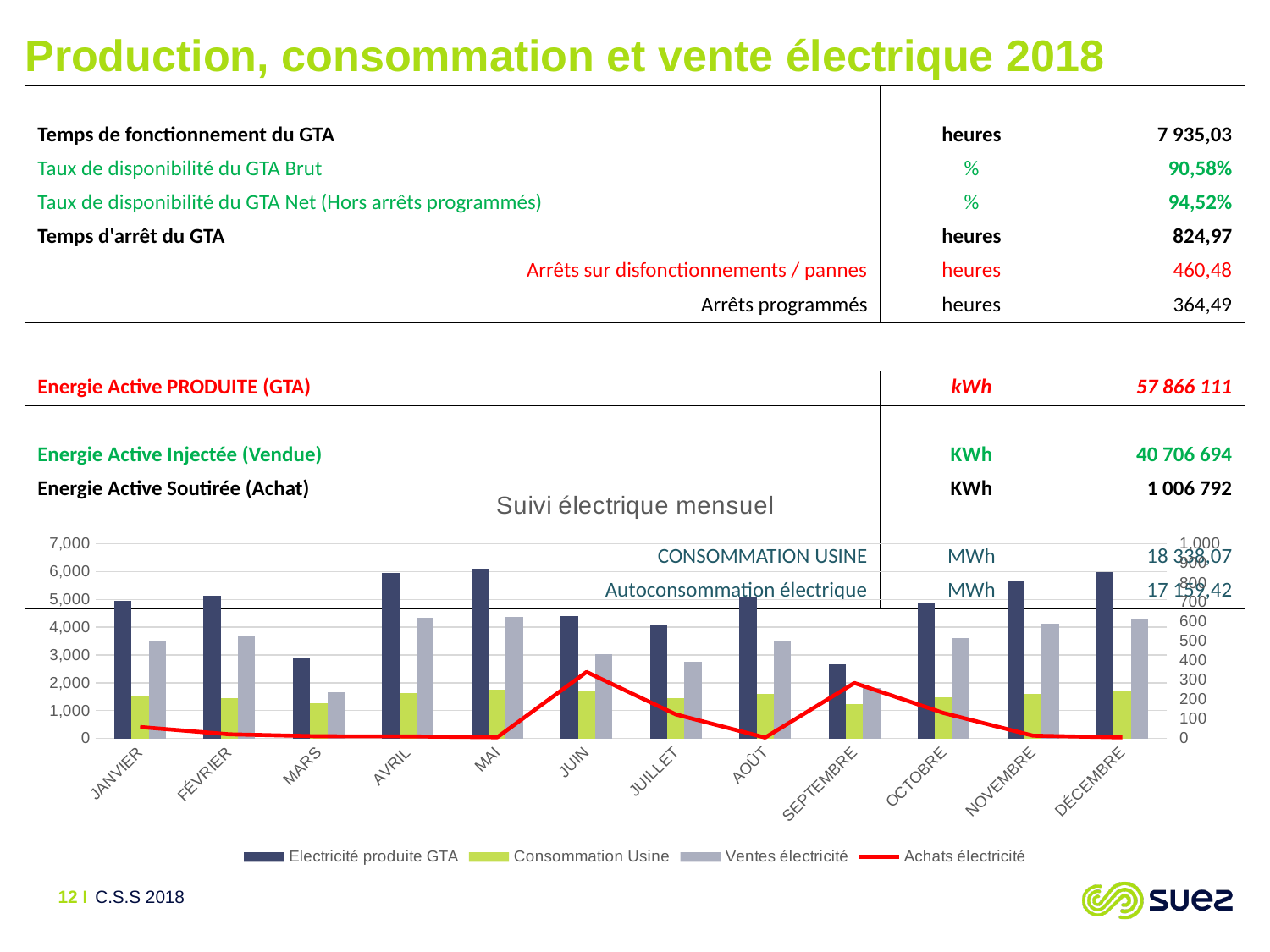
What is the title of the chart on the slide? Suivi électrique mensuel How many series does the legend of the 'Suivi électrique mensuel' chart list? 4 In the 'Suivi électrique mensuel' chart, in which month is Achats électricité highest? JUIN What kind of chart is 'Suivi électrique mensuel'? bar chart with a line In the 'Suivi électrique mensuel' chart, which is larger in AVRIL: Electricité produite GTA or Ventes électricité? Electricité produite GTA In the 'Suivi électrique mensuel' chart, which month has the lowest value of Ventes électricité? MARS How many months are shown on the x axis of the 'Suivi électrique mensuel' chart? 12 In the 'Suivi électrique mensuel' chart, is the value of Electricité produite GTA for MARS greater or less than 4,000? less In the 'Suivi électrique mensuel' chart, is the value of Consommation Usine for JANVIER greater or less than 2,000? less In the 'Suivi électrique mensuel' chart, is the value of Electricité produite GTA for MAI greater or less than 5,000? greater Which series in the 'Suivi électrique mensuel' chart is drawn as a red line? Achats électricité